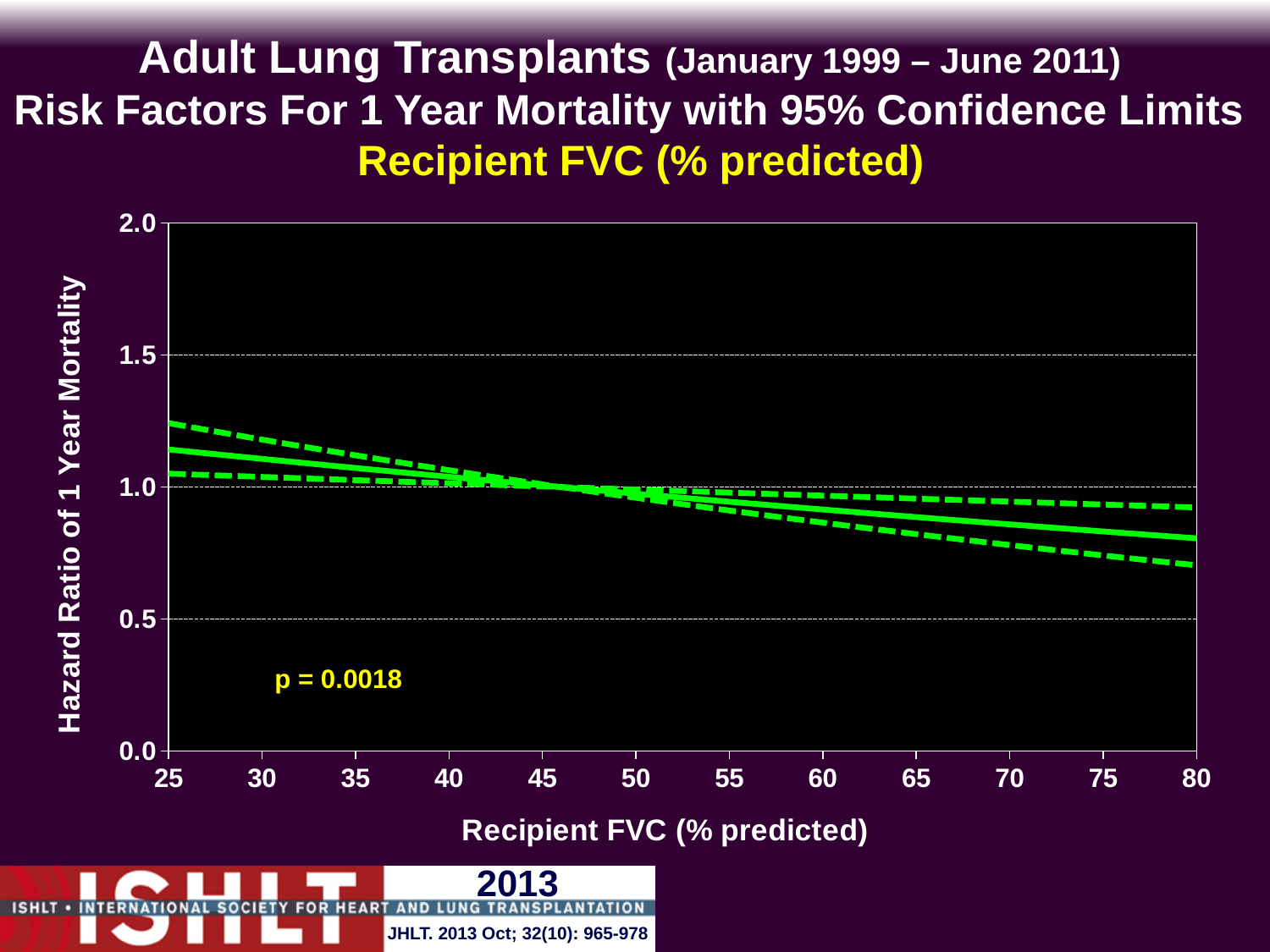
Is the hazard ratio (solid line) at a recipient FVC of 25% predicted greater or less than 1.0? greater Is the upper 95% confidence limit (upper dashed line) at a recipient FVC of 25% predicted greater or less than 1.5? less What p-value is printed on the chart? p = 0.0018 Does the hazard ratio of 1 year mortality rise or fall as recipient FVC (% predicted) increases from 25 to 80? fall What kind of chart is shown on the slide? line chart Is the upper 95% confidence limit (upper dashed line) at a recipient FVC of 80% predicted greater or less than 1.0? less How many lines are plotted on the chart? 3 What is the label of the y axis? Hazard Ratio of 1 Year Mortality